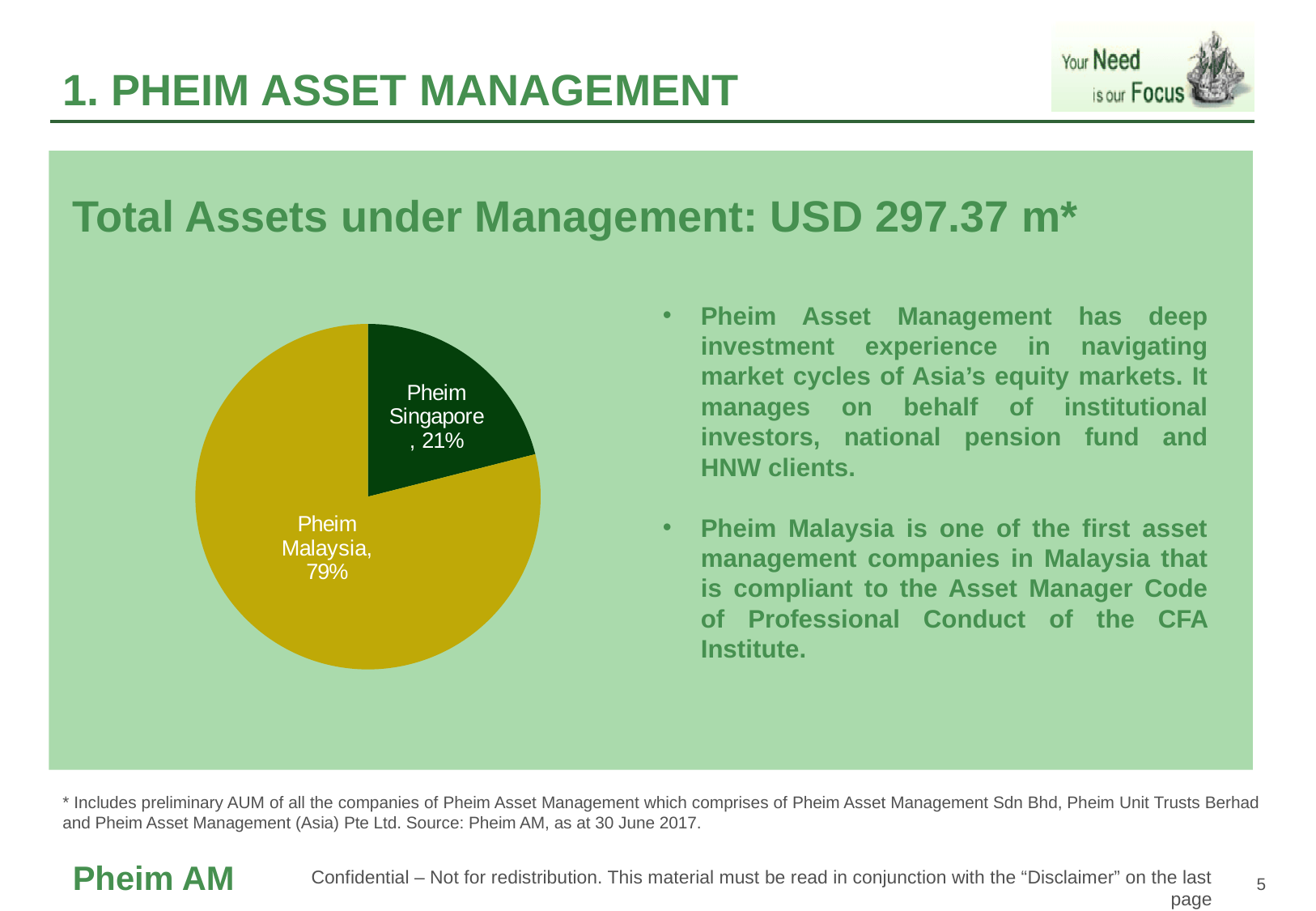
What kind of chart is shown on the slide? Pie chart What total assets under management figure is stated above the pie chart? USD 297.37 m* Which slice of the pie chart is the largest? Pheim Malaysia What is the difference in percentage points between the Pheim Malaysia and Pheim Singapore slices? 58 What colour is the Pheim Singapore slice of the pie chart? Dark green How many slices does the pie chart have? 2 What share of the pie does Pheim Singapore hold? 21% Which slice of the pie chart is the smallest? Pheim Singapore Which is larger, the Pheim Singapore slice or the Pheim Malaysia slice? Pheim Malaysia What share of the pie does Pheim Malaysia hold? 79% Is the share for Pheim Singapore greater or less than 50%? less